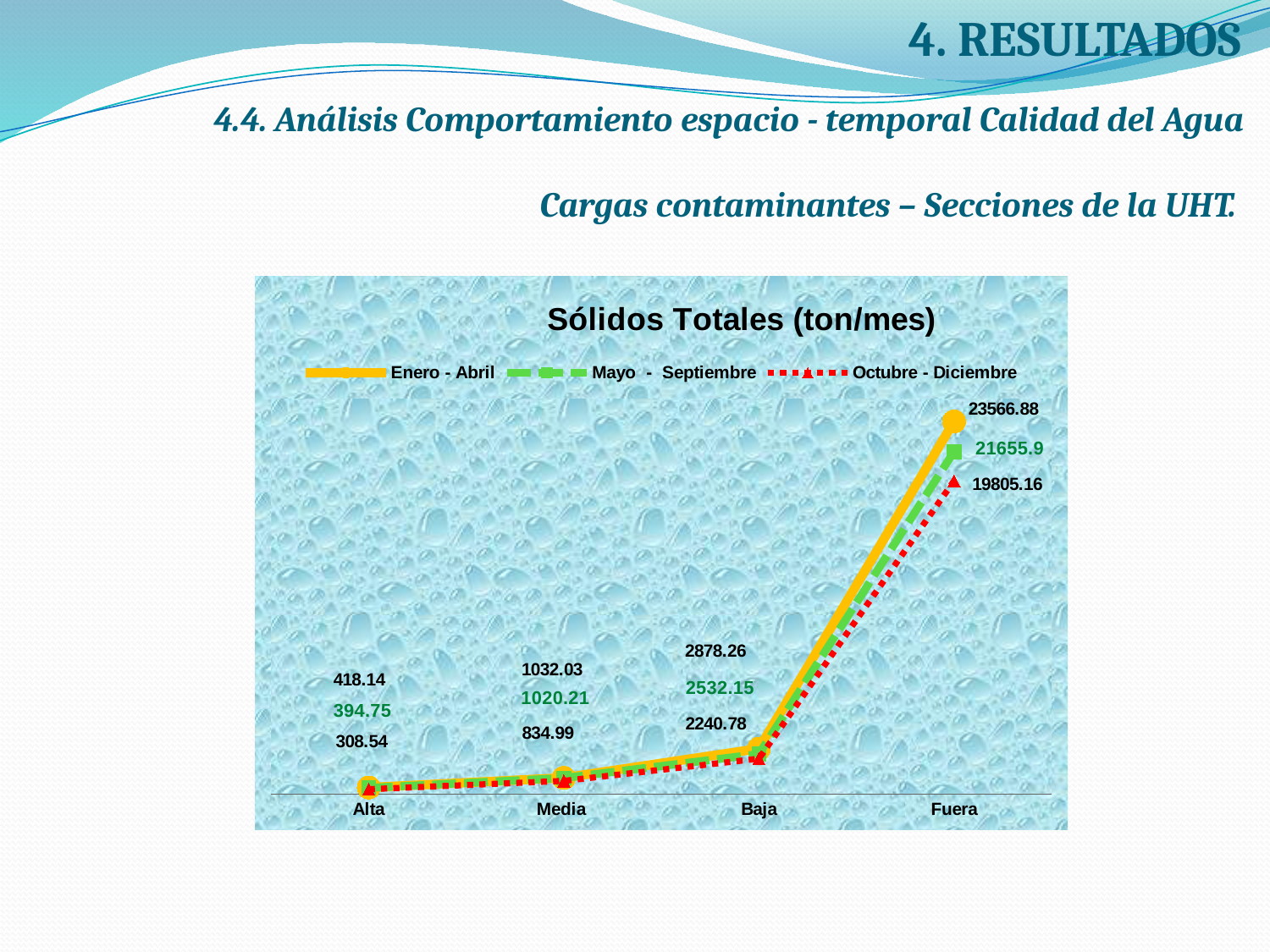
What is the title of the chart? Sólidos Totales (ton/mes) Which category has the lowest value in the Mayo - Septiembre series? Alta How many categories are shown on the x axis? 4 How many series does the legend list? 3 What is the value for Baja in the Mayo - Septiembre series? 2532.15 What is the value for Media in the Enero - Abril series? 1032.03 What is the value for Fuera in the Enero - Abril series? 23566.88 What is the difference between the Enero - Abril and Octubre - Diciembre values for Fuera? 3761.72 Do the values in the Enero - Abril series rise or fall from Alta to Fuera? Rise What kind of chart is shown on the slide? Line chart What is the value for Alta in the Octubre - Diciembre series? 308.54 Which category has the highest value in the Octubre - Diciembre series? Fuera